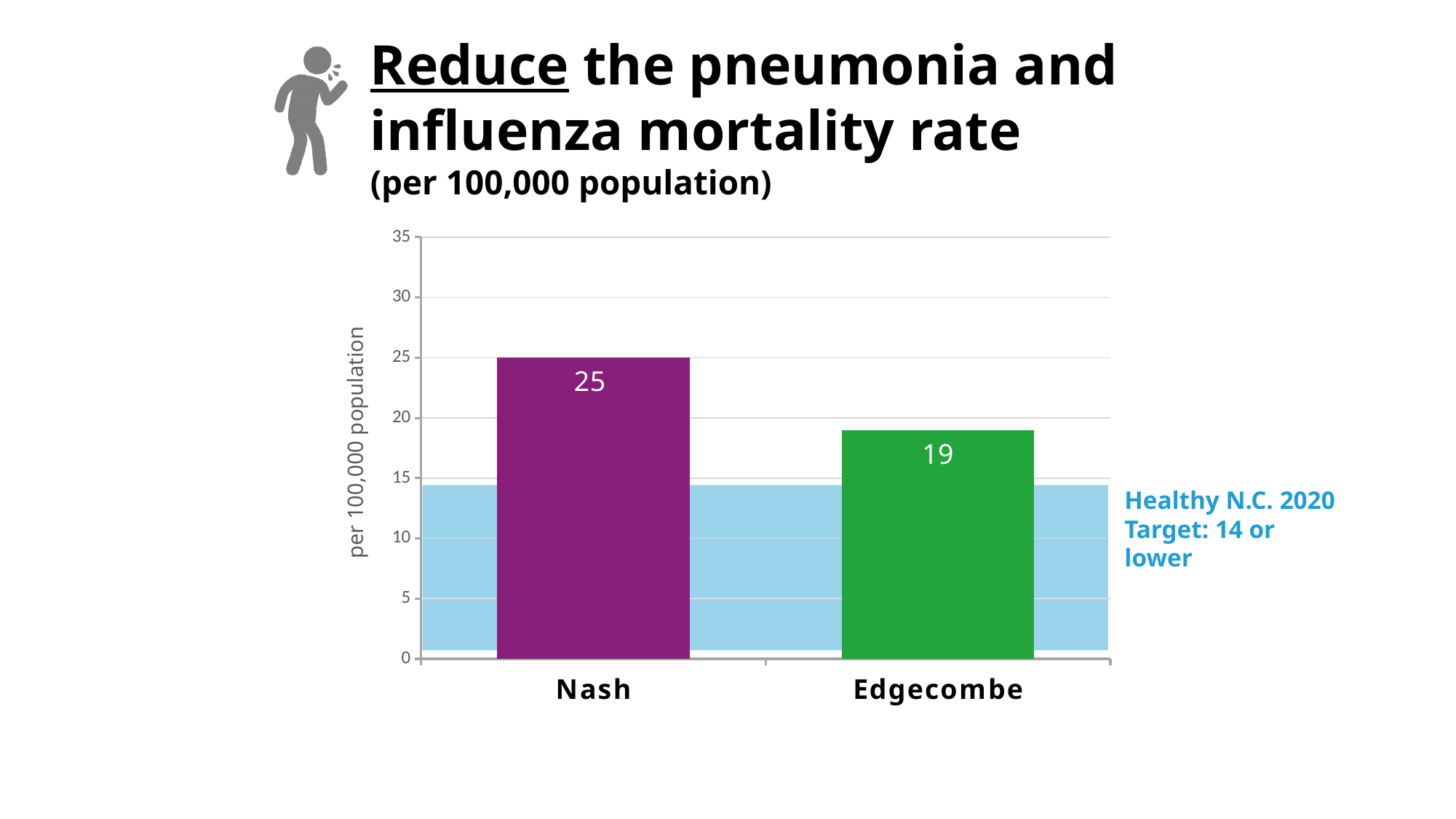
Is the value for Nash greater or less than 20? greater How many counties are shown in the chart? 2 What is the difference between the mortality rates for Nash and Edgecombe? 6 What is the Healthy N.C. 2020 target shown on the slide? 14 or lower Which county has the higher pneumonia and influenza mortality rate? Nash What kind of chart is shown on the slide? bar chart What is the pneumonia and influenza mortality rate for Edgecombe? 19 What is the label on the vertical axis of the chart? per 100,000 population Which county has the lower pneumonia and influenza mortality rate? Edgecombe Is the mortality rate for Nash or Edgecombe larger? Nash What is the pneumonia and influenza mortality rate for Nash? 25 Is the value for Edgecombe greater or less than 20? less